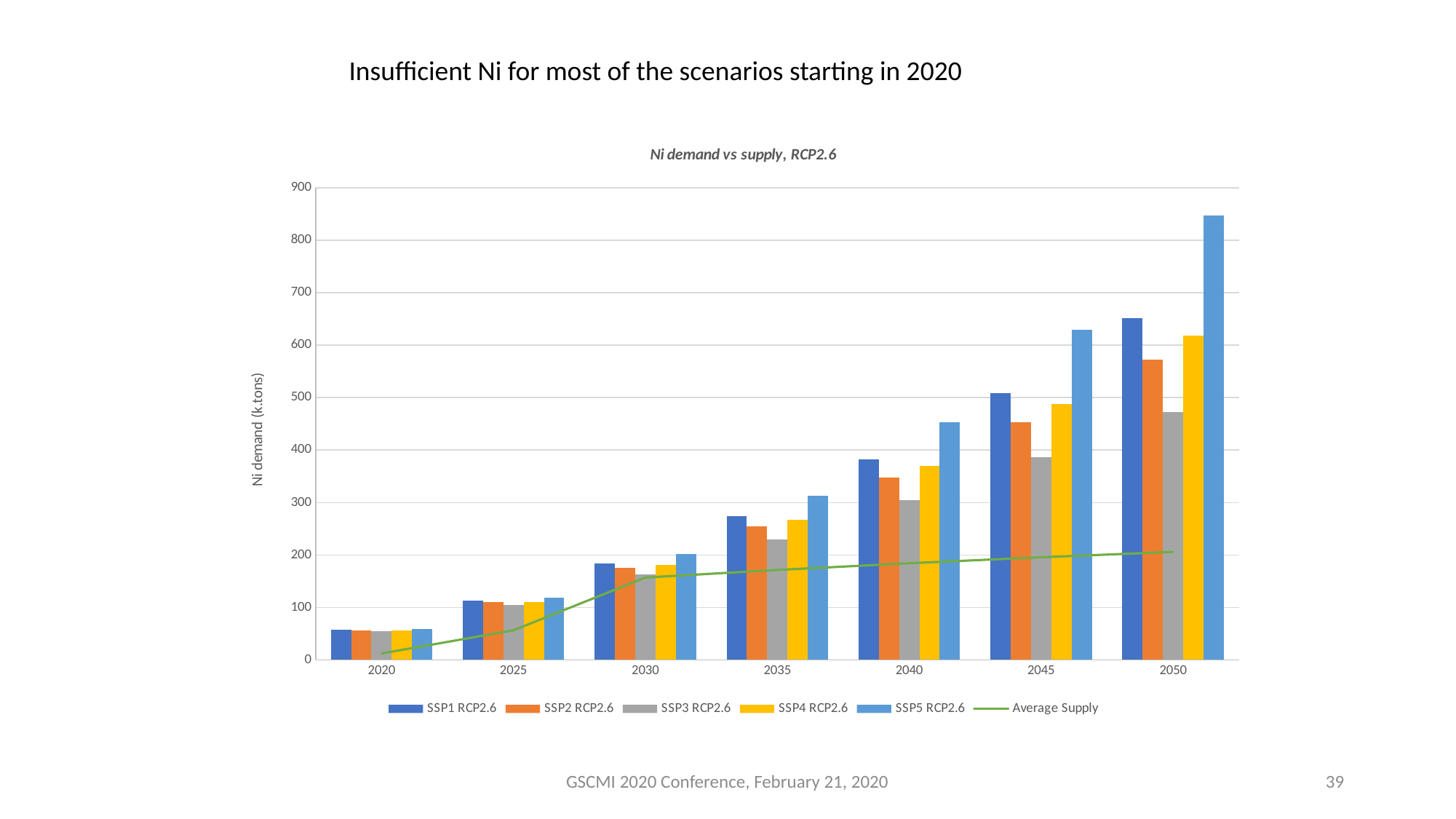
Is the value for SSP3 RCP2.6 in 2050 greater or less than 500? less What is the label on the vertical axis of the chart? Ni demand (k.tons) Is the Average Supply value in 2030 greater or less than 200? less What kind of chart is used to show the SSP scenario series? bar chart Is the value for SSP5 RCP2.6 in 2050 greater or less than 800? greater Does the SSP5 RCP2.6 demand rise or fall from 2020 to 2050? rise How many series does the legend list? 6 Which series has the tallest bar in 2050? SSP5 RCP2.6 Which series has the shortest bar in 2050? SSP3 RCP2.6 What is the title of the chart? Ni demand vs supply, RCP2.6 In 2045, which is larger: SSP1 RCP2.6 or SSP2 RCP2.6? SSP1 RCP2.6 How many years are shown along the x axis? 7